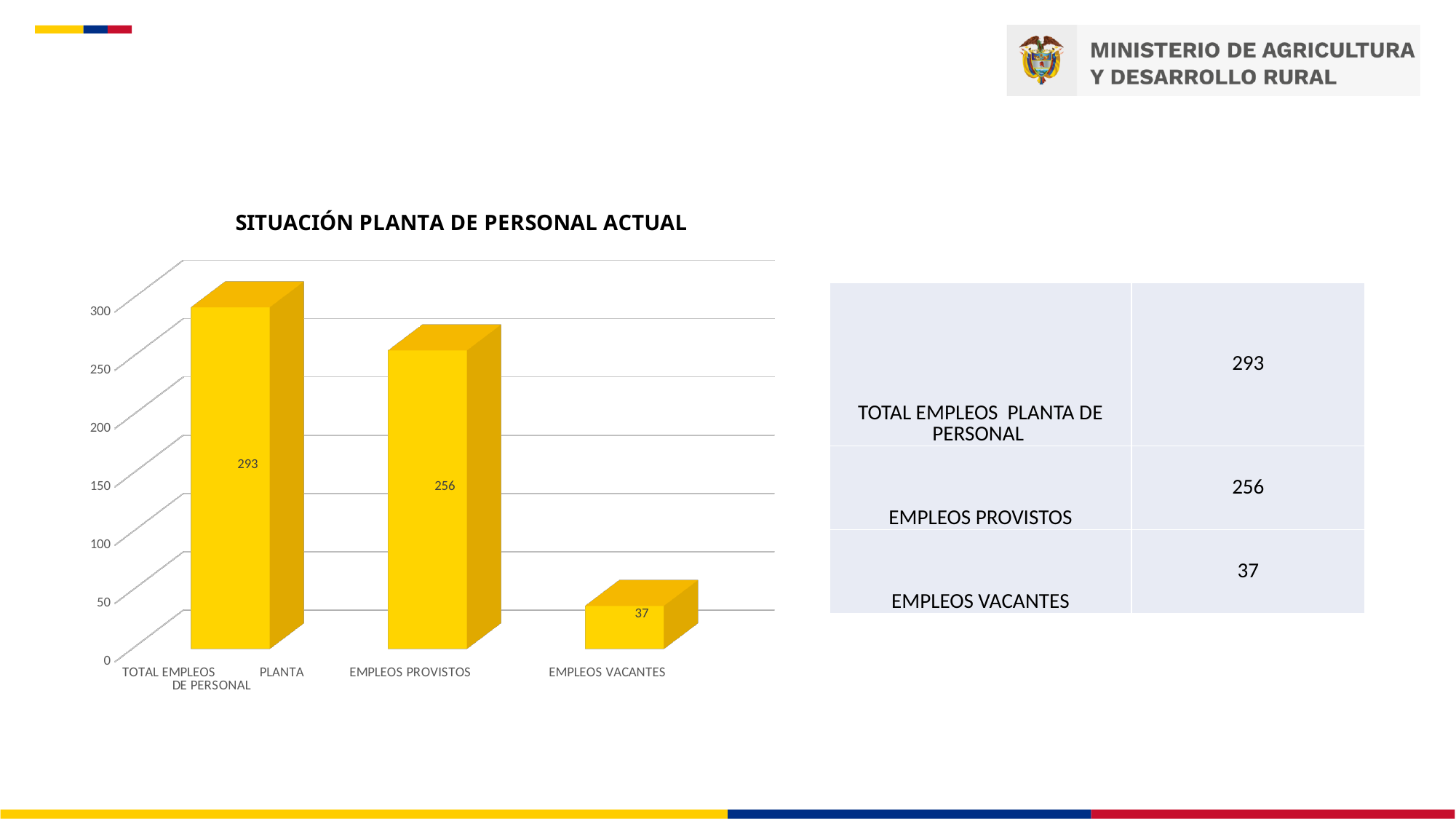
What is the value for EMPLEOS VACANTES? 37 What is the value for TOTAL EMPLEOS PLANTA DE PERSONAL? 293 Which category has the highest value? TOTAL EMPLEOS PLANTA DE PERSONAL How many categories are shown in the chart? 3 What is the difference between EMPLEOS PROVISTOS and EMPLEOS VACANTES? 219 What kind of chart is shown on the slide? bar chart What is the title of the chart? SITUACIÓN PLANTA DE PERSONAL ACTUAL Which is larger, EMPLEOS PROVISTOS or EMPLEOS VACANTES? EMPLEOS PROVISTOS What is the value for EMPLEOS PROVISTOS? 256 What is the difference between TOTAL EMPLEOS PLANTA DE PERSONAL and EMPLEOS PROVISTOS? 37 Is the value for EMPLEOS VACANTES greater or less than 50? less Which category has the lowest value? EMPLEOS VACANTES